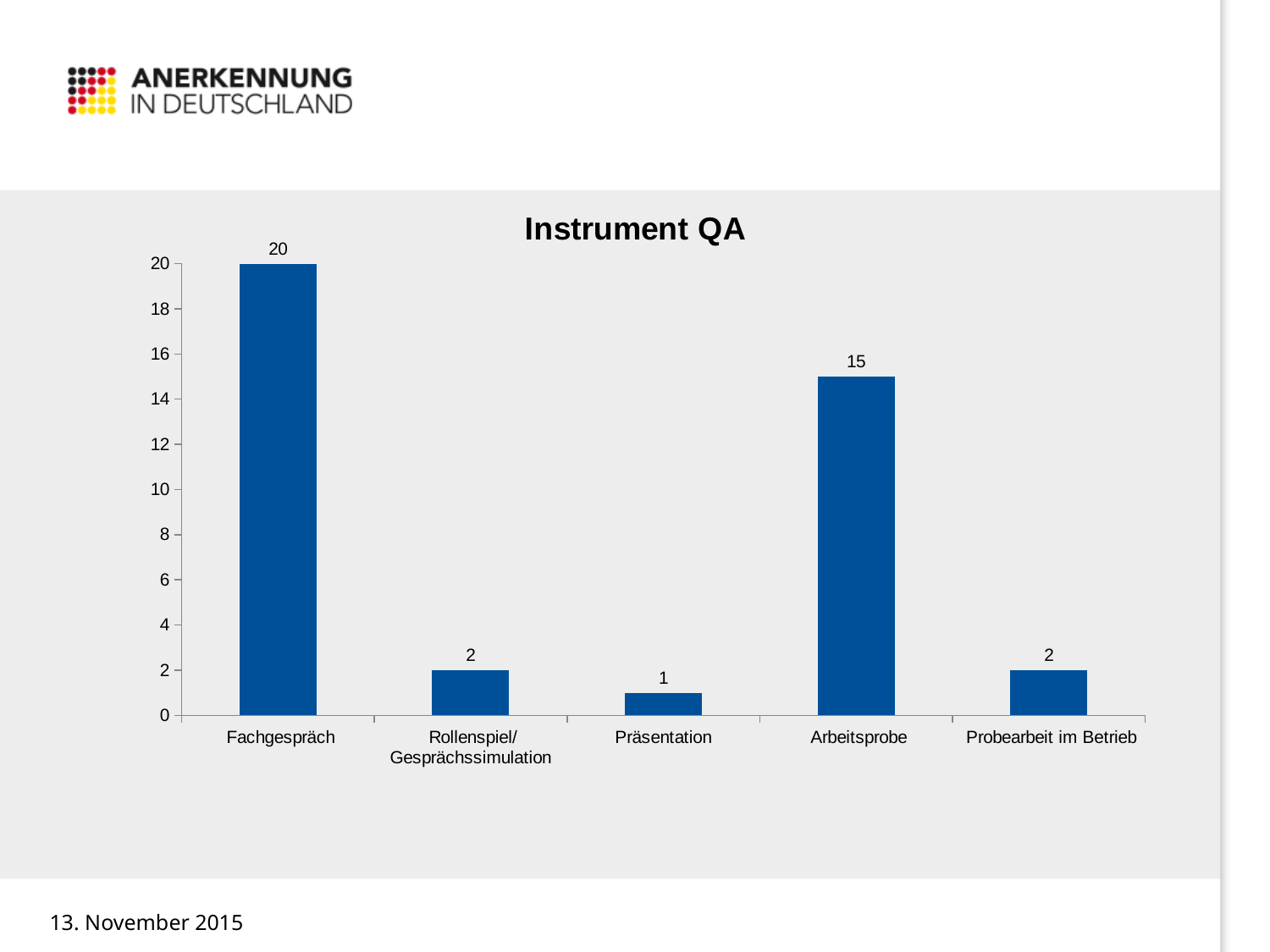
What is the value for Probearbeit im Betrieb? 2 How many categories are shown on the x axis? 5 Which category has the lowest value? Präsentation What kind of chart is shown on the slide? bar chart What is the title of the chart? Instrument QA Which category has the highest value? Fachgespräch What is the value for Arbeitsprobe? 15 What is the difference between the values for Fachgespräch and Arbeitsprobe? 5 Is the value for Arbeitsprobe greater or less than 10? greater Which is larger, the value for Arbeitsprobe or the value for Rollenspiel/Gesprächssimulation? Arbeitsprobe What is the value for Präsentation? 1 What is the value for Fachgespräch? 20